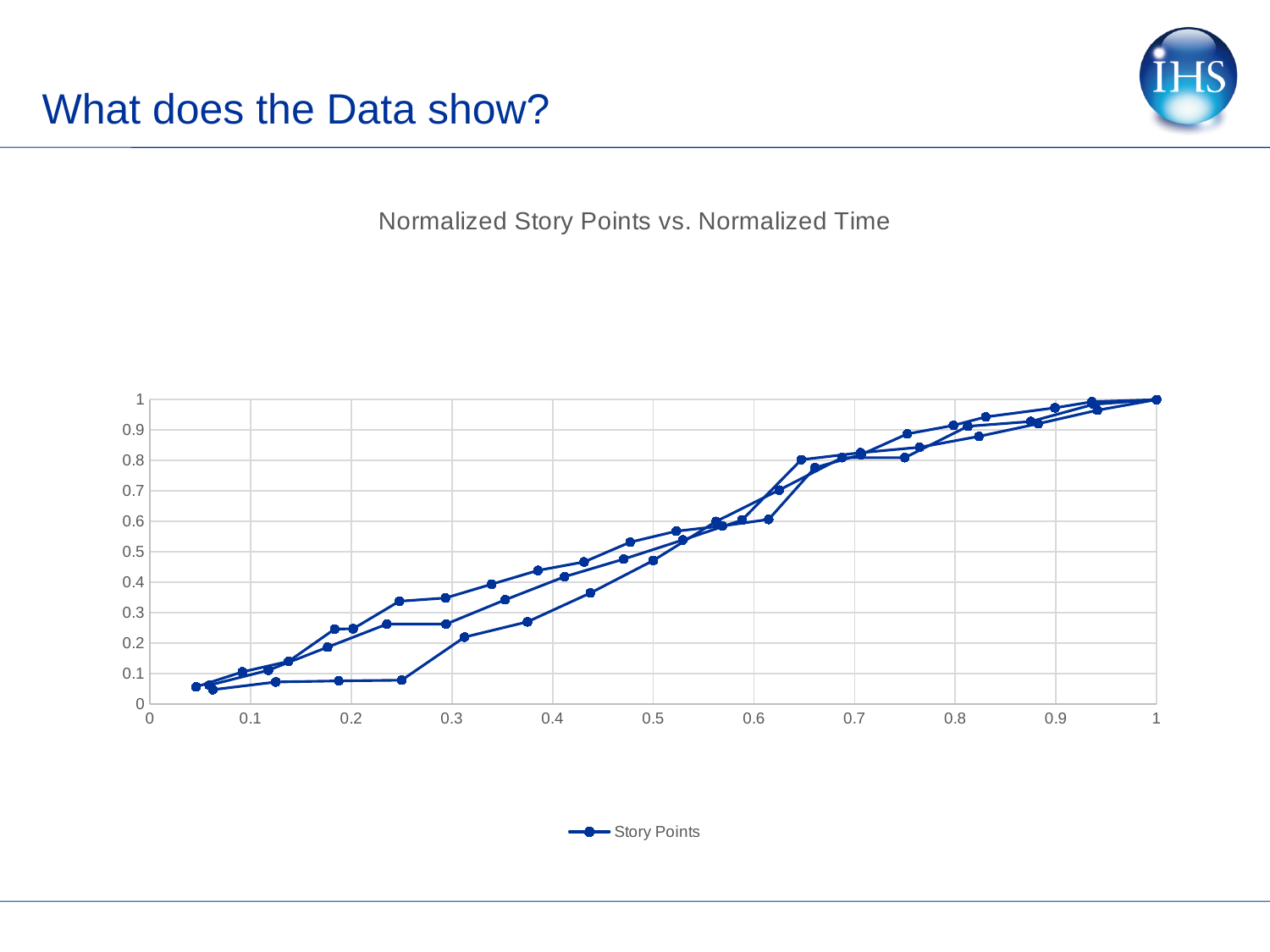
What is the name of the series shown in the legend? Story Points Is the value of the lines at x = 0.8 greater or less than 0.7? greater Do the plotted values generally rise or fall as normalized time increases along the x axis? rise How many series does the legend list? 1 Is the value of the lines at x = 0.9 greater or less than 0.8? greater Is the value of the lines at x = 0.7 greater or less than 0.6? greater What kind of chart is shown on the slide? line chart What is the highest value shown on the y axis? 1 What value do the lines reach at the right end of the x axis, where x equals 1? 1 What is the title of the chart? Normalized Story Points vs. Normalized Time